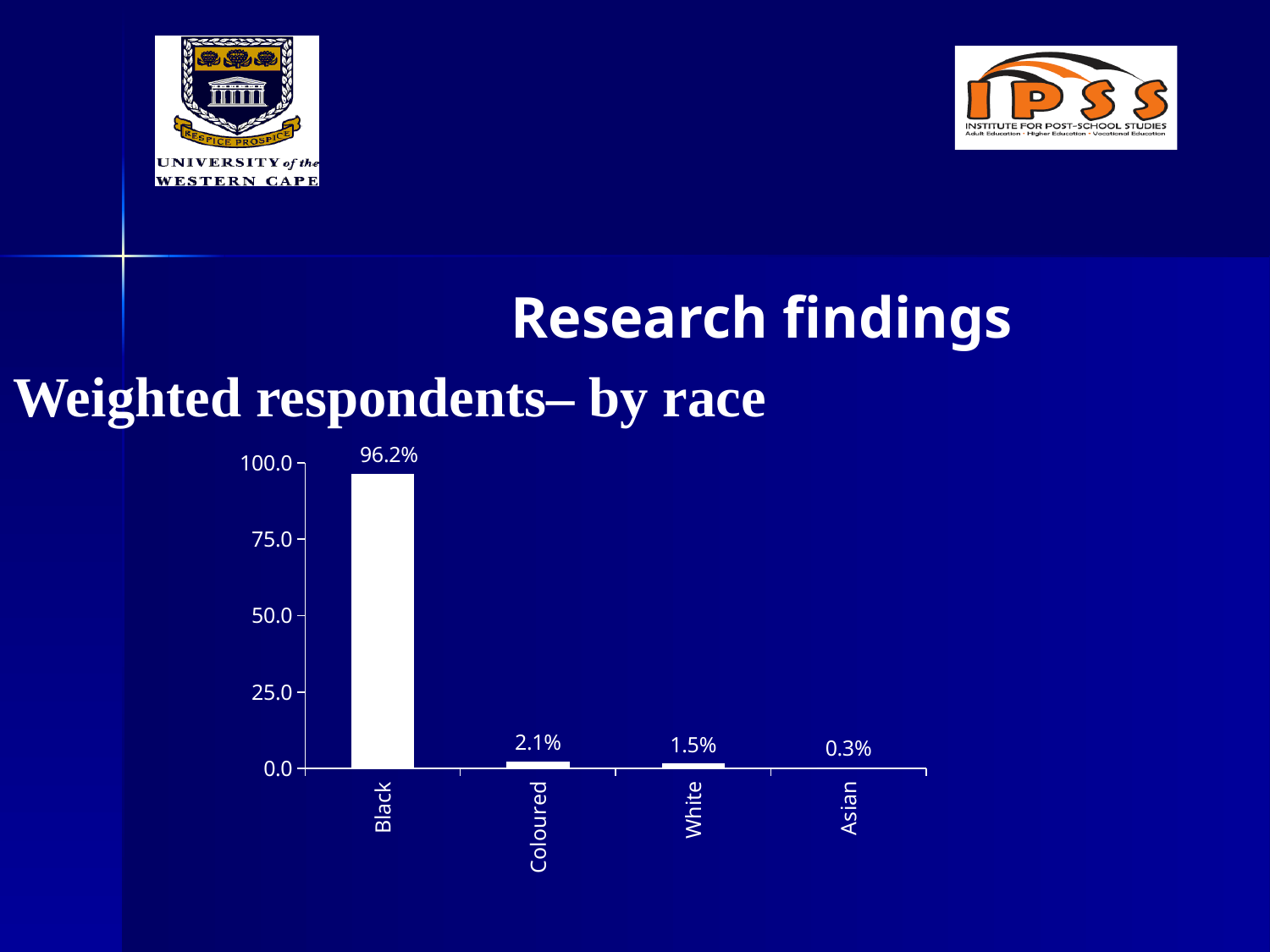
What is the difference between the values for Coloured and White? 0.6% Is the value for Black greater or less than 75.0? greater What kind of chart is shown on the slide? bar chart What is the value for Asian? 0.3% Which category has the highest value? Black What is the value for White? 1.5% Which category has the lowest value? Asian Which is larger, the value for White or the value for Asian? White What is the value for Black? 96.2% How many categories are shown on the x axis? 4 What is the difference between the values for Black and Coloured? 94.1% What is the value for Coloured? 2.1%